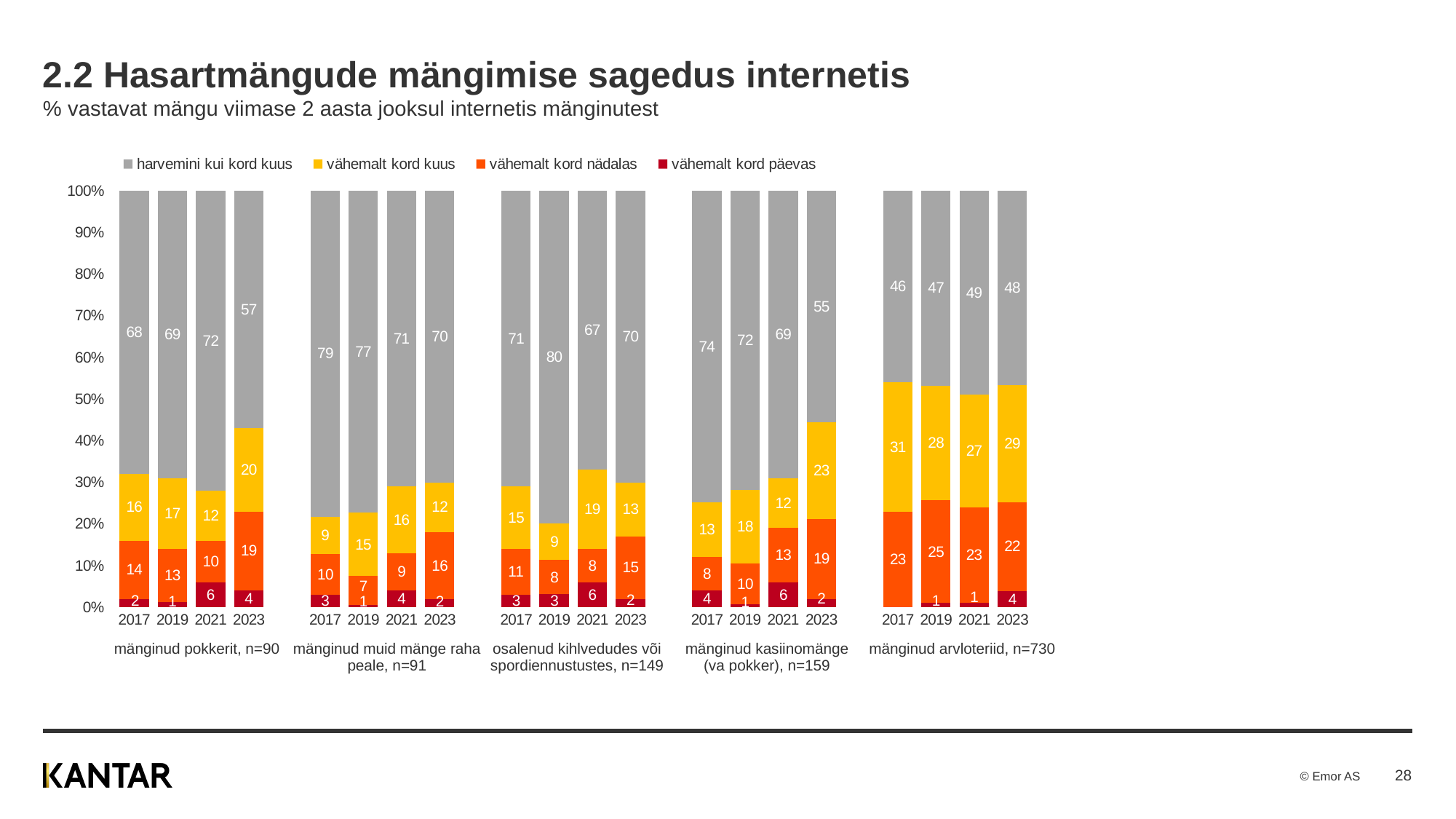
What is the value of 'vähemalt kord nädalas' for 2023 in the 'mänginud kasiinomänge (va pokker), n=159' group? 19 How many series does the legend list? 4 In the 'mänginud muid mänge raha peale, n=91' group, which year has the highest 'harvemini kui kord kuus' value? 2017 In the 'mänginud kasiinomänge (va pokker), n=159' group, which year has the lowest 'harvemini kui kord kuus' value? 2023 Which colour represents 'vähemalt kord päevas' in the legend? dark red What is the value of 'harvemini kui kord kuus' for 2023 in the 'mänginud pokkerit, n=90' group? 57 What kind of chart is shown on the slide? stacked bar chart What is the value of 'vähemalt kord päevas' for 2021 in the 'osalenud kihlvedudes või spordiennustustes, n=149' group? 6 Which is larger: the 'vähemalt kord nädalas' value for 2019 or for 2023 in the 'mänginud muid mänge raha peale, n=91' group? 2023 What is the difference between the 'vähemalt kord kuus' values for 2023 and 2021 in the 'mänginud pokkerit, n=90' group? 8 How many year categories are shown in each group of the chart? 4 What is the value of 'vähemalt kord kuus' for 2017 in the 'mänginud arvloteriid, n=730' group? 31